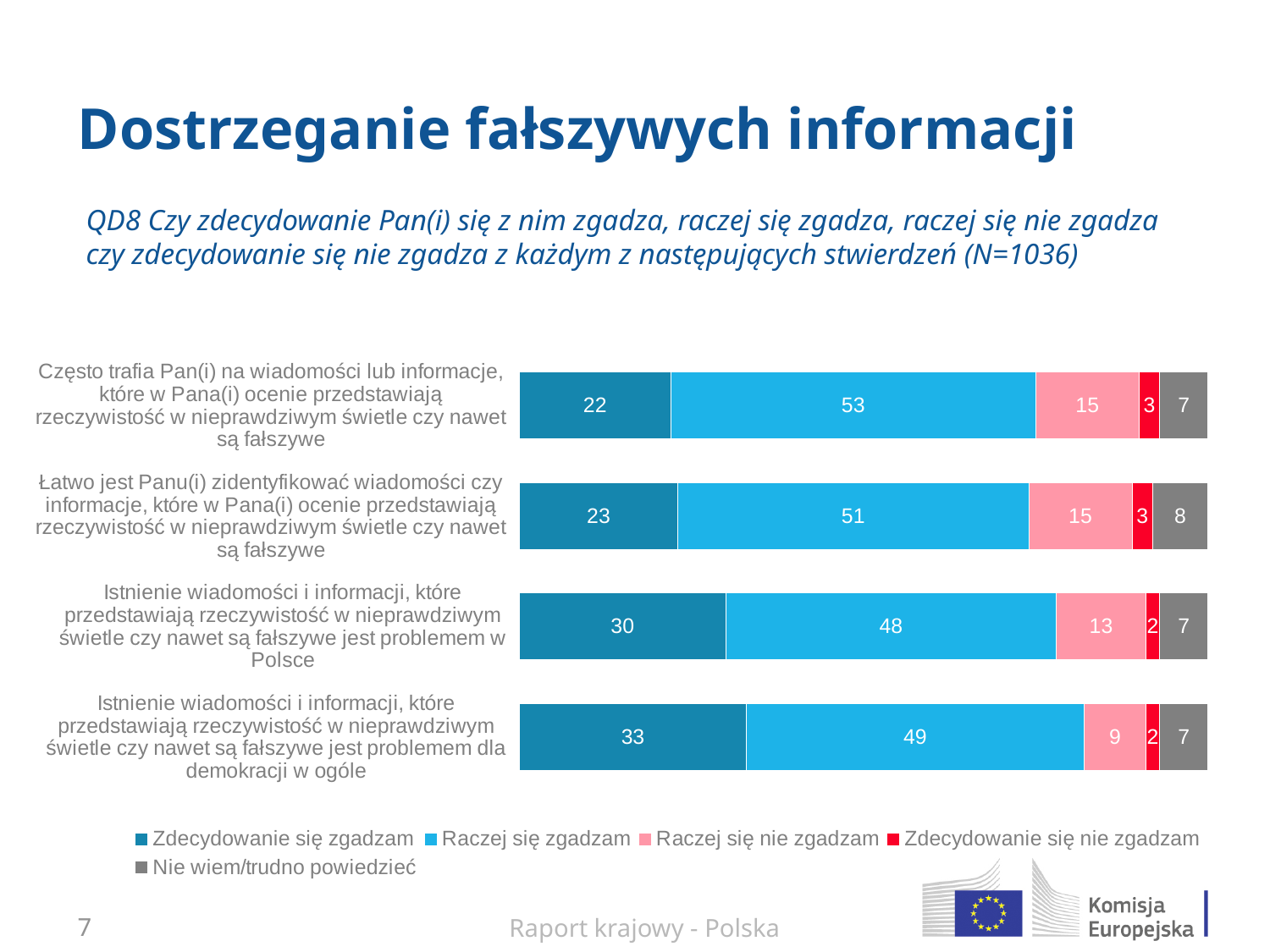
Which is larger: the 'Raczej się zgadzam' value for 'Często trafia Pan(i) na wiadomości...' or for 'Łatwo jest Panu(i) zidentyfikować wiadomości...'? Często trafia Pan(i) na wiadomości... What kind of chart is shown on the slide? Stacked bar chart What is the difference between the 'Zdecydowanie się zgadzam' values for the statement about a problem for democracy in general (33) and the statement about a problem in Poland (30)? 3 What is the 'Zdecydowanie się zgadzam' value for the statement 'Istnienie wiadomości i informacji, które przedstawiają rzeczywistość w nieprawdziwym świetle czy nawet są fałszywe jest problemem dla demokracji w ogóle'? 33 How many series does the legend list? 5 Which statement has the lowest 'Raczej się nie zgadzam' value? Istnienie wiadomości i informacji, które przedstawiają rzeczywistość w nieprawdziwym świetle czy nawet są fałszywe jest problemem dla demokracji w ogóle What is the combined total of 'Zdecydowanie się zgadzam' and 'Raczej się zgadzam' for the statement 'Istnienie wiadomości i informacji... jest problemem w Polsce'? 78 What is the 'Raczej się zgadzam' value for the statement 'Często trafia Pan(i) na wiadomości lub informacje, które w Pana(i) ocenie przedstawiają rzeczywistość w nieprawdziwym świetle czy nawet są fałszywe'? 53 Which statement has the highest 'Zdecydowanie się zgadzam' value? Istnienie wiadomości i informacji, które przedstawiają rzeczywistość w nieprawdziwym świetle czy nawet są fałszywe jest problemem dla demokracji w ogóle What is the 'Nie wiem/trudno powiedzieć' value for the statement 'Łatwo jest Panu(i) zidentyfikować wiadomości czy informacje, które w Pana(i) ocenie przedstawiają rzeczywistość w nieprawdziwym świetle czy nawet są fałszywe'? 8 Which legend entry is shown in red? Zdecydowanie się nie zgadzam How many statements (categories) are plotted in the chart? 4